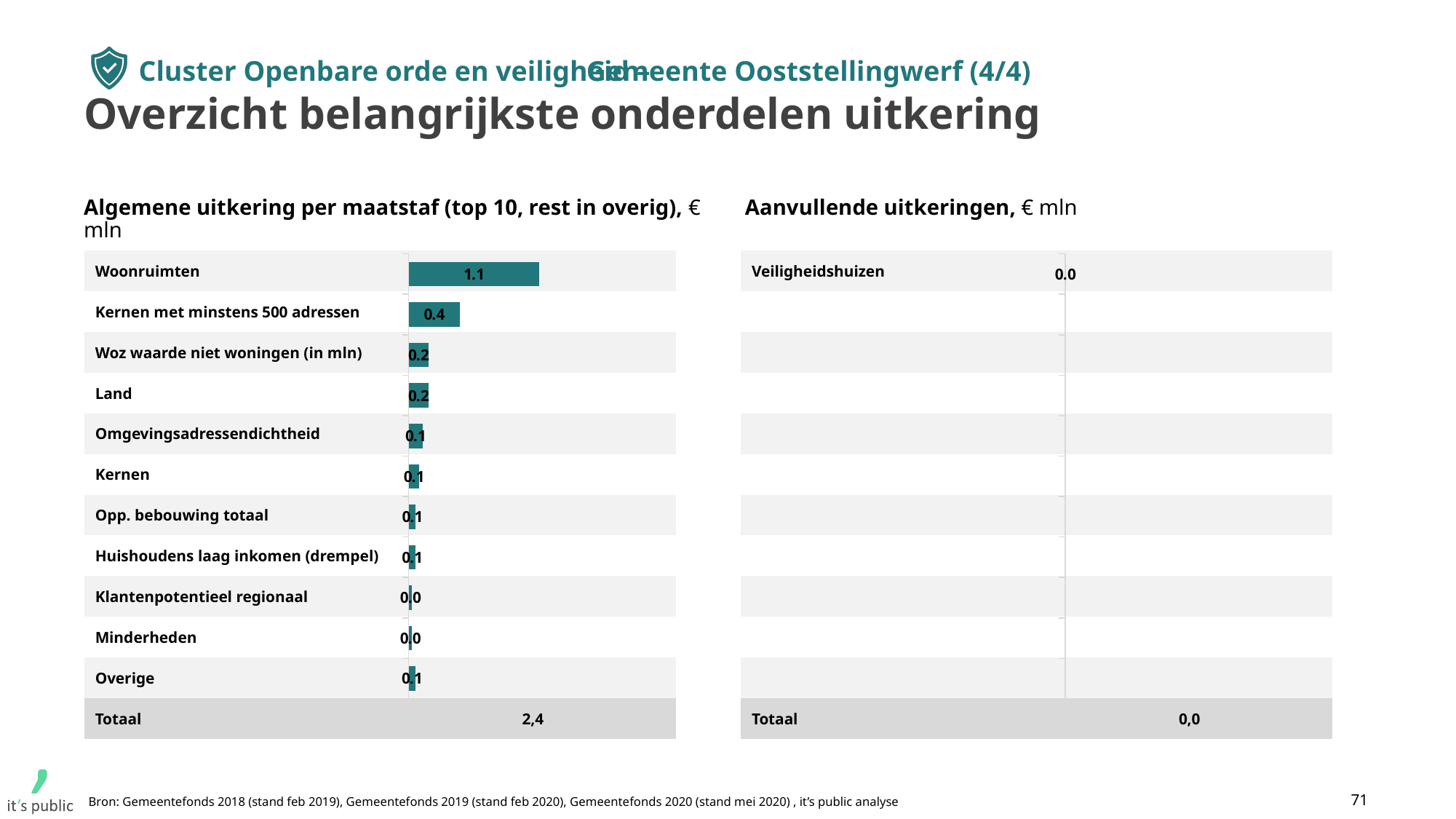
In the chart 'Algemene uitkering per maatstaf', what is the difference between the values for Woonruimten and Kernen met minstens 500 adressen? 0.7 How many categories (excluding the Totaal row) are shown in the chart 'Algemene uitkering per maatstaf'? 11 In the chart 'Algemene uitkering per maatstaf', which is larger: the value for Woz waarde niet woningen (in mln) or the value for Kernen? Woz waarde niet woningen (in mln) In the chart 'Aanvullende uitkeringen', what is the value for Veiligheidshuizen? 0.0 What is the Totaal shown for the chart 'Algemene uitkering per maatstaf'? 2,4 In the chart 'Algemene uitkering per maatstaf', what is the value for Land? 0.2 What unit is stated in the title of the chart 'Aanvullende uitkeringen'? € mln In the chart 'Algemene uitkering per maatstaf', which category has the highest value? Woonruimten In the chart 'Algemene uitkering per maatstaf', what is the value for Kernen met minstens 500 adressen? 0.4 In the chart 'Algemene uitkering per maatstaf', what is the value for Woonruimten? 1.1 What is the Totaal shown for the chart 'Aanvullende uitkeringen'? 0,0 What kind of chart is 'Algemene uitkering per maatstaf'? Bar chart